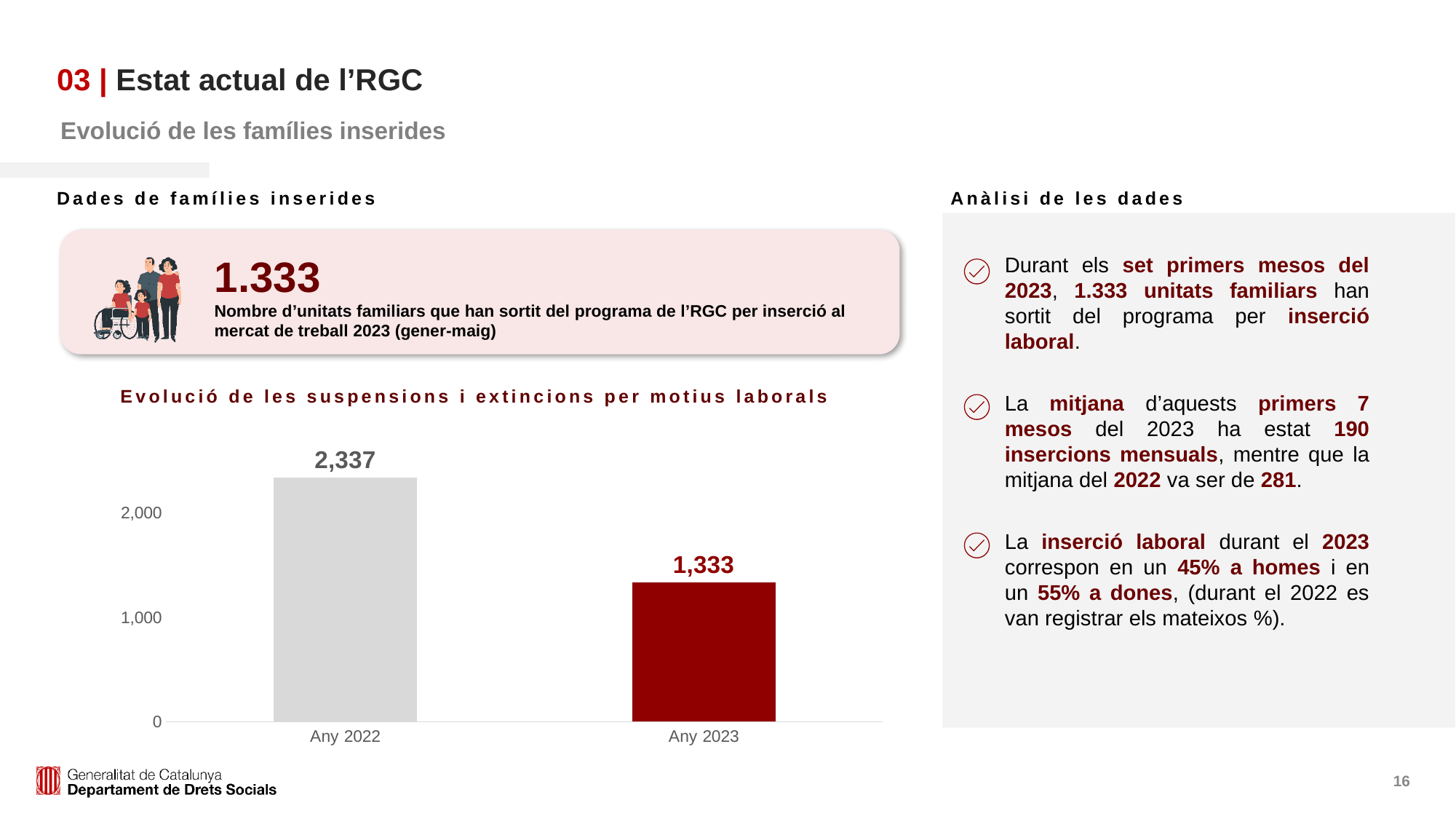
How many categories are shown on the x axis? 2 What kind of chart is shown on the slide? bar chart Do the values rise or fall from Any 2022 to Any 2023? fall Is the value for Any 2023 greater or less than 2,000? less What is the value for Any 2023? 1,333 Which category has the lowest value? Any 2023 What is the value for Any 2022? 2,337 Which is larger, the value for Any 2022 or Any 2023? Any 2022 Is the value for Any 2022 greater or less than 2,000? greater What is the difference between the values for Any 2022 and Any 2023? 1,004 Which category has the highest value? Any 2022 What is the title of the chart? Evolució de les suspensions i extincions per motius laborals